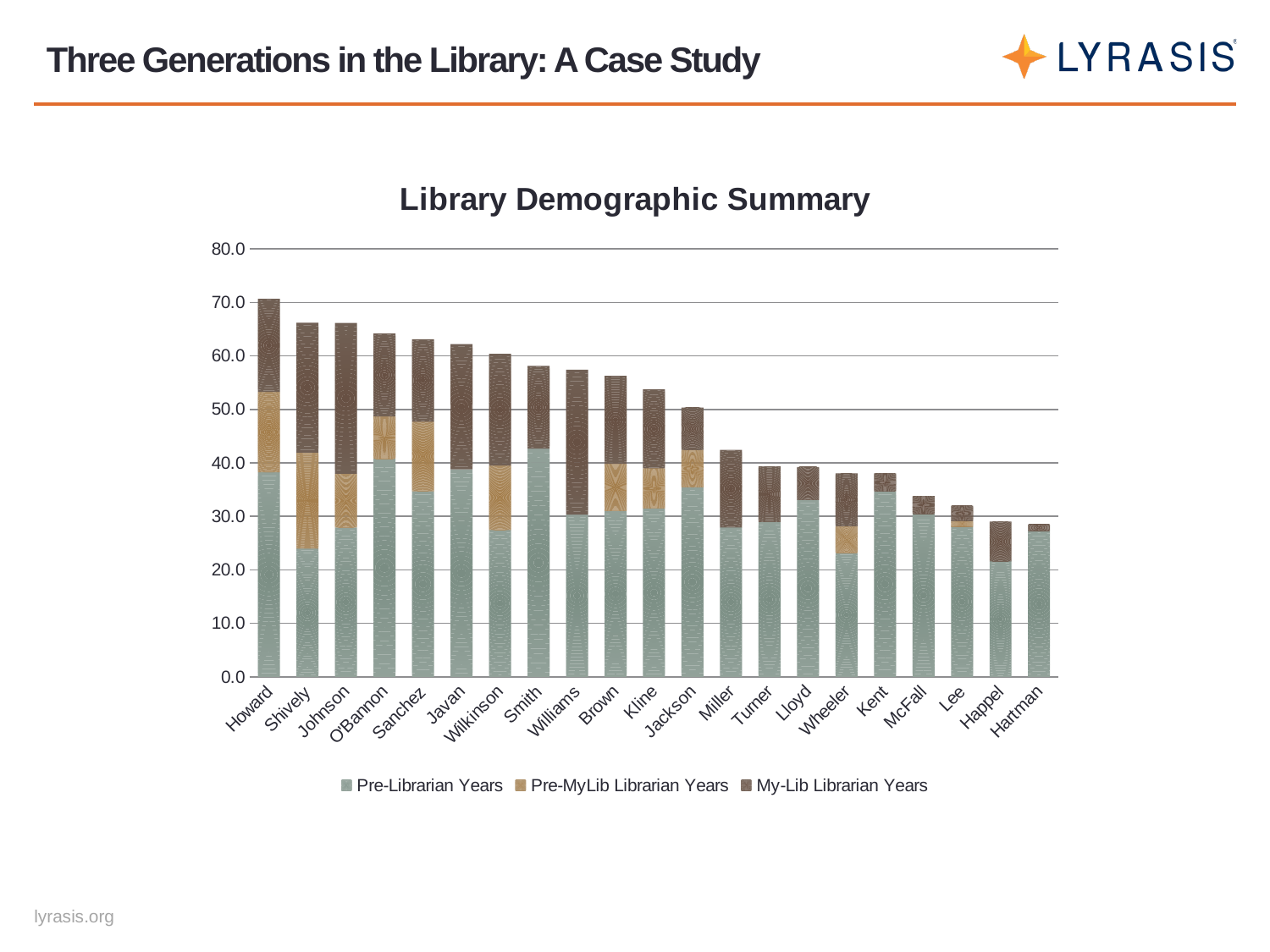
What is the title of the chart? Library Demographic Summary Which person has the highest total bar? Howard Which series is listed first in the legend? Pre-Librarian Years How many people (categories) are shown along the x axis? 21 Is the total value for Hartman greater or less than 30.0? less Which has the larger total bar, Howard or Hartman? Howard Is the total value for Kent greater or less than 40.0? less How many series does the legend list? 3 Is the total value for Shively greater or less than 60.0? greater Do the total bar heights rise or fall moving from left to right along the x axis? Fall What kind of chart is shown on the slide? Stacked bar chart